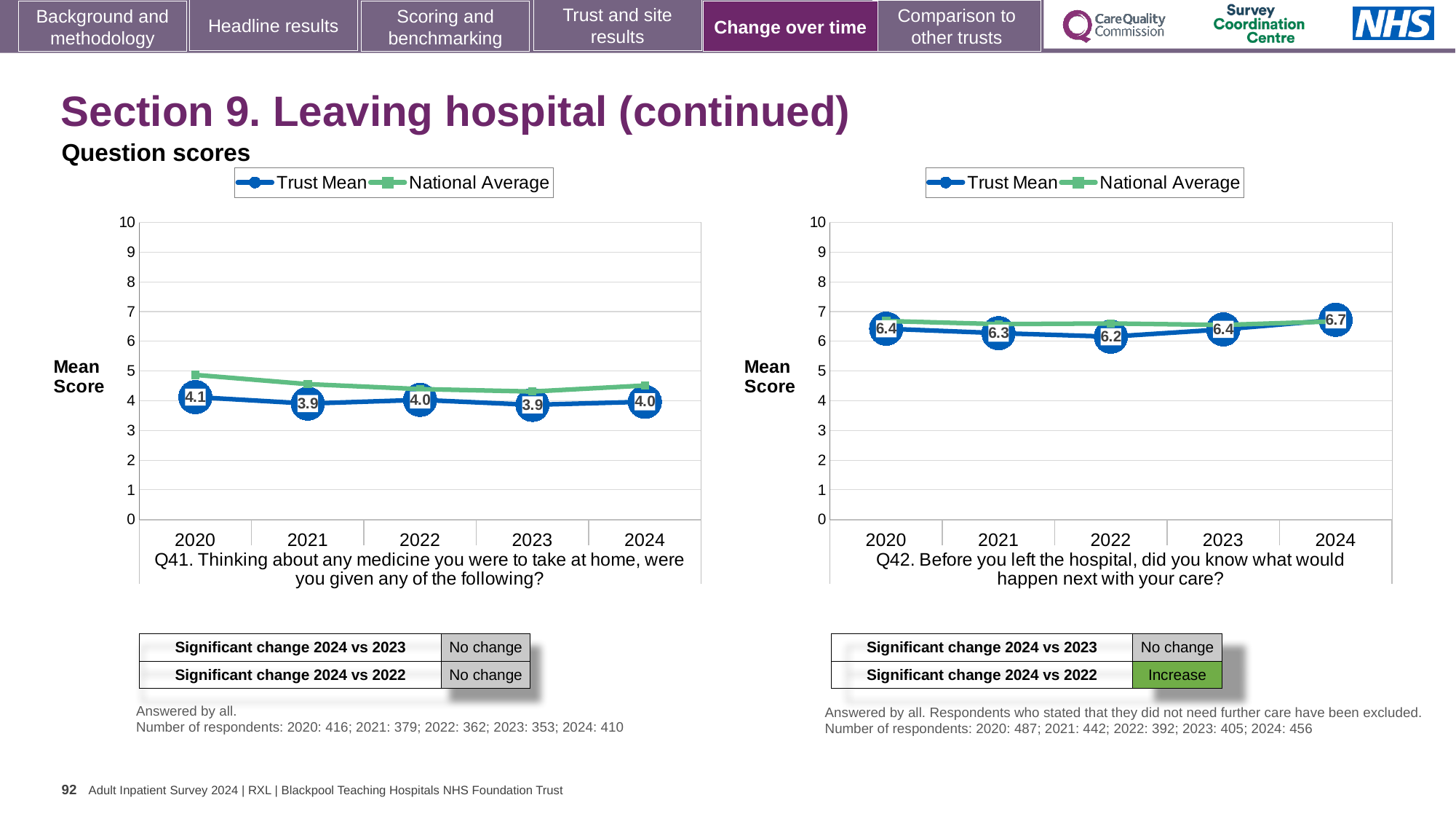
On the Q42 chart (right), what is the Trust Mean score for 2022? 6.2 On the Q41 chart (left), in which year is the Trust Mean highest? 2020 On the Q41 chart (left), what is the Trust Mean score for 2020? 4.1 On the Q42 chart (right), is the National Average for 2020 greater or less than 7? less How many series does the legend of the Q42 chart (right) list? 2 On the Q41 chart (left), which is higher in 2020: the Trust Mean or the National Average? National Average On the Q42 chart (right), what is the difference between the Trust Mean in 2024 and in 2022? 0.5 What kind of chart is the Q41 chart (left)? Line chart On the Q42 chart (right), what is the Trust Mean score for 2024? 6.7 On the Q42 chart (right), in which year is the Trust Mean lowest? 2022 How many years are shown on the x axis of the Q41 chart (left)? 5 On the Q42 chart (right), does the Trust Mean rise or fall from 2022 to 2024? Rise